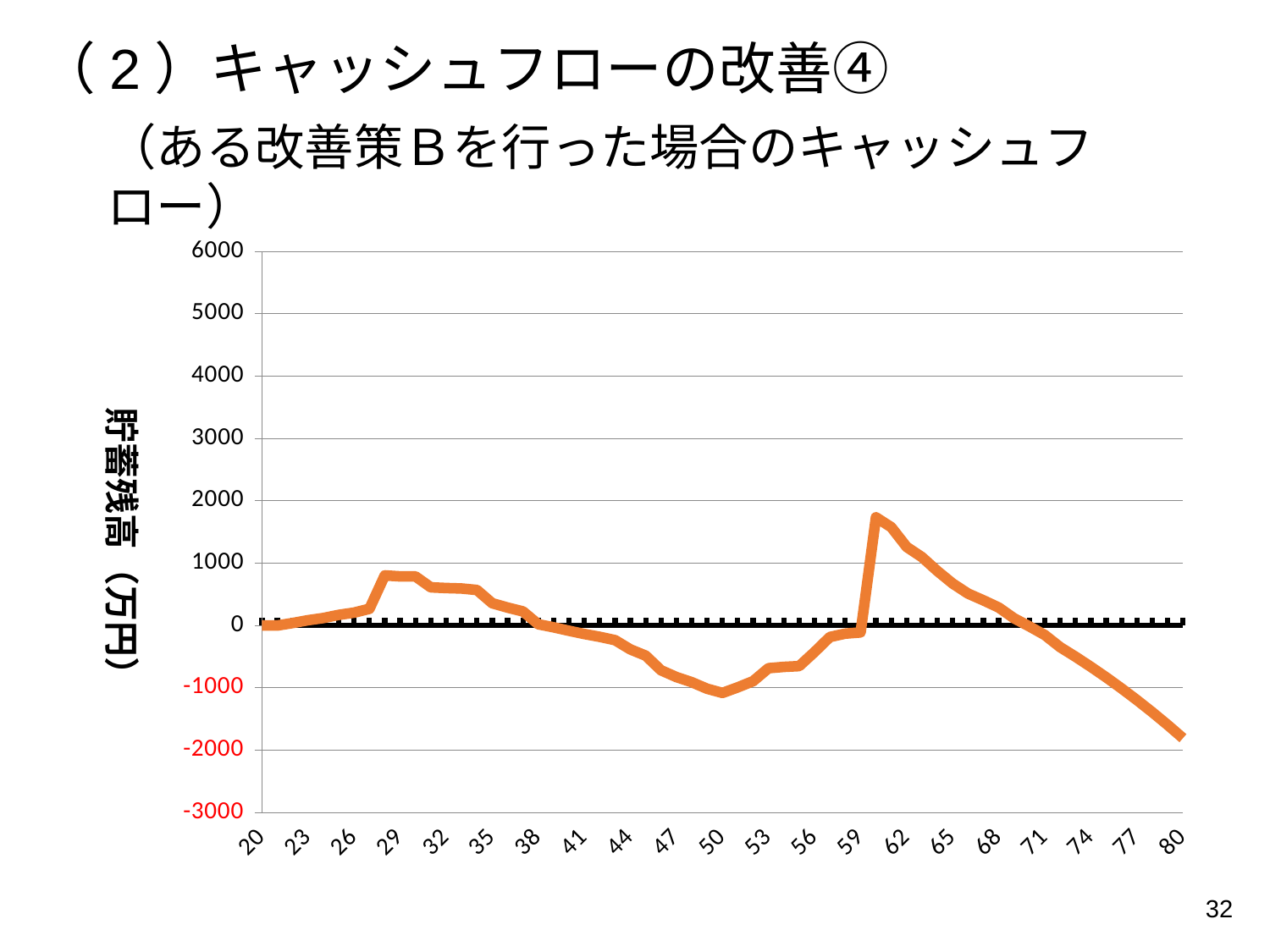
At which labeled age is the value lowest? 80 Is the value at age 80 greater or less than -1000? less What is the y-axis title of the chart? 貯蓄残高（万円） Is the value at age 74 greater or less than 0? less Does the line rise or fall from age 38 to age 50? fall Is the value at age 29 greater or less than 0? greater What kind of chart is shown on the slide? line chart Does the line rise or fall from age 62 to age 80? fall What is the highest value shown on the y-axis? 6000 How many age labels are shown on the x-axis? 21